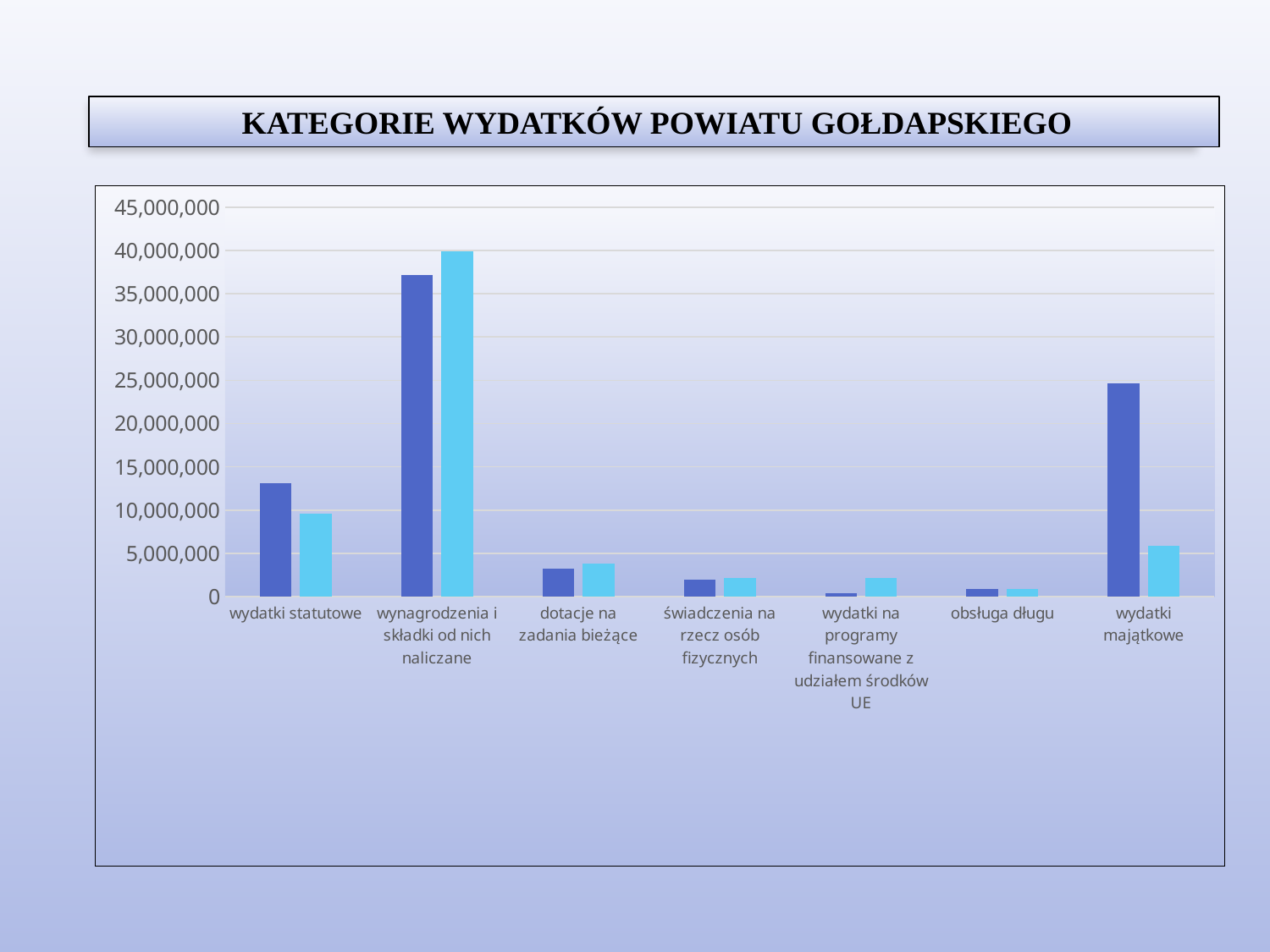
Is the light blue bar for wydatki majątkowe greater or less than 10,000,000? less For wynagrodzenia i składki od nich naliczane, which bar is taller, the dark blue one or the light blue one? light blue Which category has the tallest light blue bar? wynagrodzenia i składki od nich naliczane Is the dark blue bar for wynagrodzenia i składki od nich naliczane greater or less than 35,000,000? greater How many expenditure categories are shown on the x axis of the chart? 7 Is the dark blue bar for wydatki majątkowe greater or less than 20,000,000? greater Which category has the shortest dark blue bar? wydatki na programy finansowane z udziałem środków UE What kind of chart is shown on the slide? bar chart Which category has the tallest dark blue bar? wynagrodzenia i składki od nich naliczane For wydatki statutowe, which bar is taller, the dark blue one or the light blue one? dark blue What is the title of the slide above the chart? KATEGORIE WYDATKÓW POWIATU GOŁDAPSKIEGO